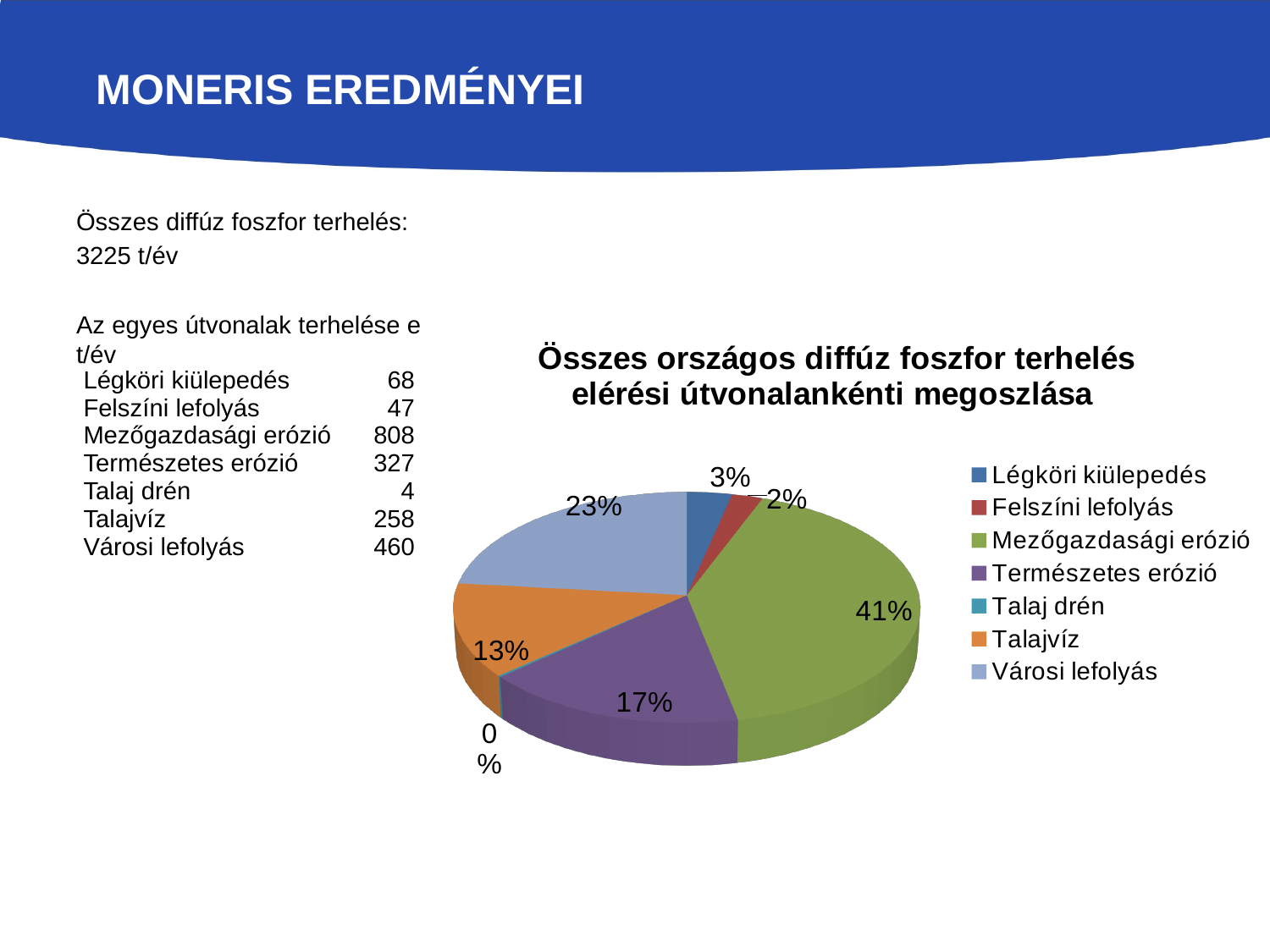
Which category has the largest slice of the pie? Mezőgazdasági erózió Which category has the smallest slice of the pie? Talaj drén What is the difference in percentage points between the Mezőgazdasági erózió slice and the Városi lefolyás slice? 18 What share of the pie does Természetes erózió have? 17% What is the chart's title? Összes országos diffúz foszfor terhelés elérési útvonalankénti megoszlása What share of the pie does Talajvíz have? 13% What kind of chart is shown on the slide? pie chart What share of the pie does Légköri kiülepedés have? 3% Which slice is larger, Természetes erózió or Talajvíz? Természetes erózió How many categories does the legend of the pie chart list? 7